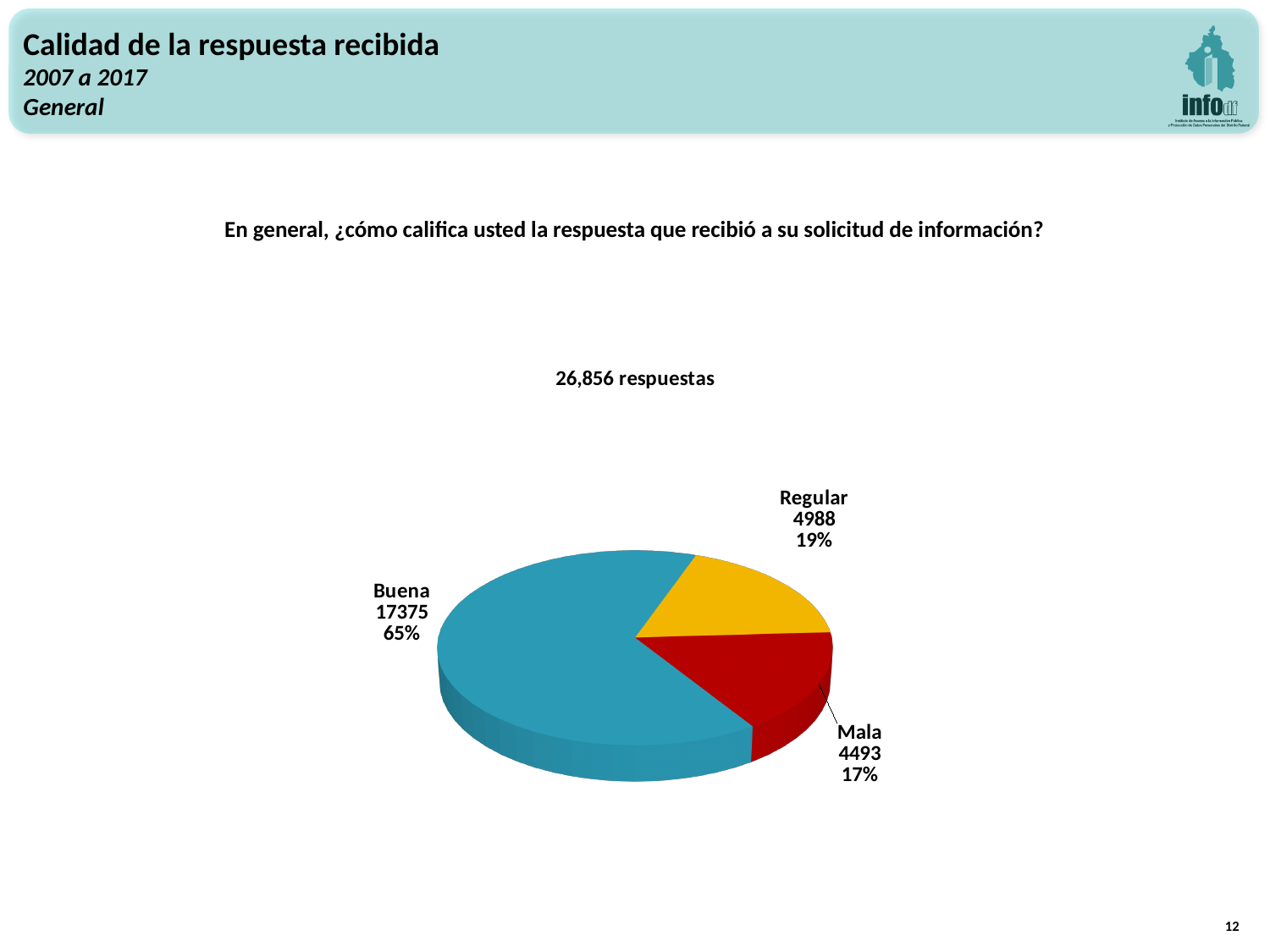
What is the difference in responses between Regular and Mala? 495 Which category has the largest slice of the pie? Buena What percentage of responses does the Buena slice represent? 65% What percentage of responses does the Regular slice represent? 19% How many responses are labelled for the Buena slice? 17375 What kind of chart is shown on the slide? pie chart Which has more responses, Regular or Mala? Regular How many responses does the chart say were counted in total? 26,856 respuestas Which category has the smallest slice of the pie? Mala What colour is the Buena slice? blue How many categories does the pie chart show? 3 How many responses are labelled for the Mala slice? 4493